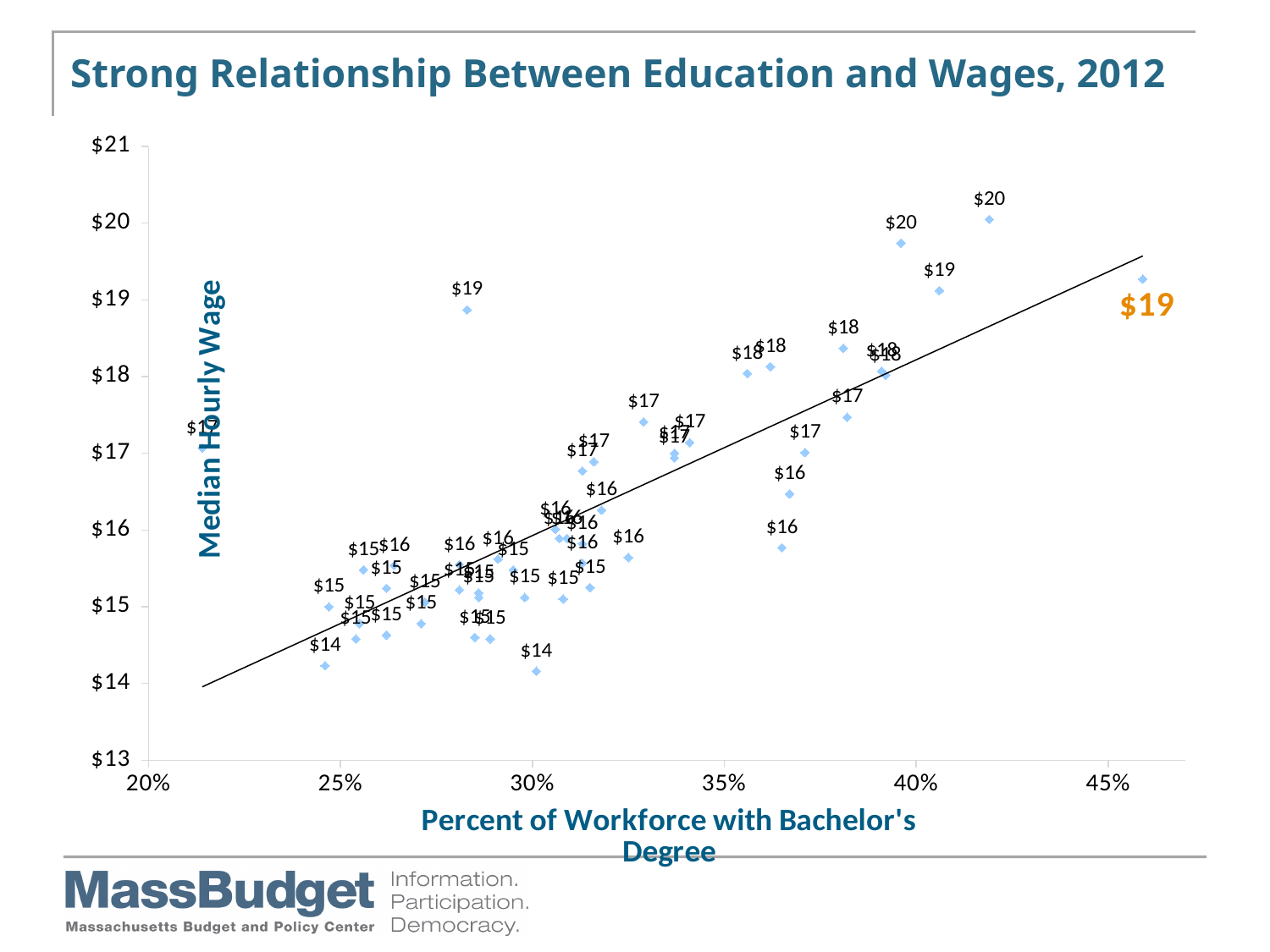
What is the title of the chart? Strong Relationship Between Education and Wages, 2012 What is the highest median hourly wage value labeled on the chart? $20 As the percent of workforce with a bachelor's degree increases along the x axis, do median hourly wages generally rise or fall? rise What is the difference between the highest labeled wage ($20) and the lowest labeled wage ($14)? $6 Which is larger: the wage for the point at about 42% labeled $20 or the wage for the point at about 30% labeled $14? the point at about 42% ($20) What kind of chart is shown on the slide? scatter chart What is the label of the vertical axis? Median Hourly Wage What is the highest value shown on the vertical axis? $21 What is the lowest median hourly wage value labeled on the chart? $14 Is the median hourly wage for the point farthest to the right (around 46%) greater or less than $18? greater What wage value is shown in the orange highlighted data label at the far right of the chart? $19 Is the median hourly wage for the lowest point near 30% on the x axis greater or less than $15? less